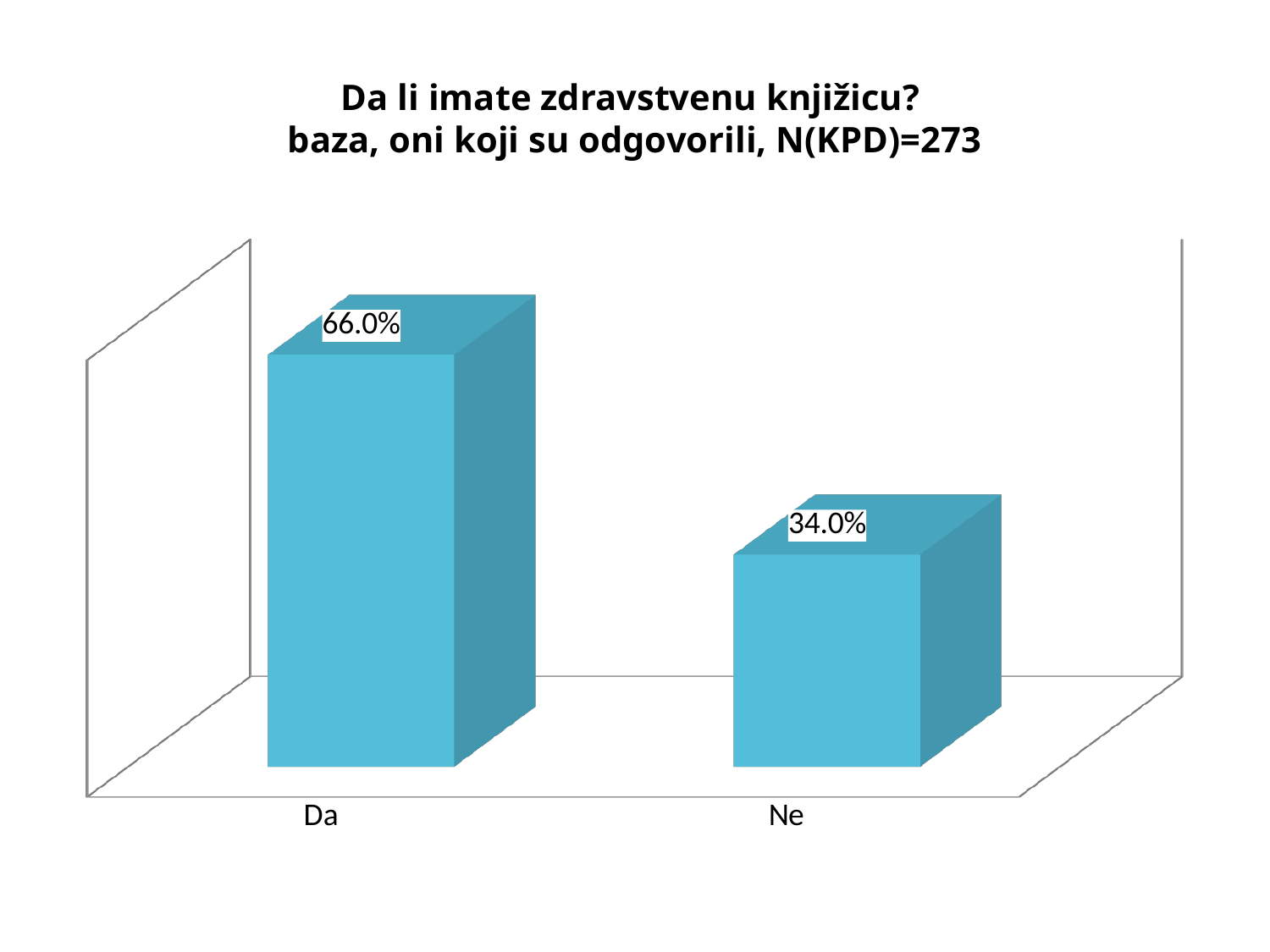
Which category has the highest value? Da Do the values rise or fall from "Da" to "Ne"? fall What is the value for "Ne"? 34.0% Which is larger, the value for "Da" or the value for "Ne"? Da What is the difference between the values for "Da" and "Ne"? 32.0% How many categories are shown on the x axis? 2 What is the total of the two values shown? 100.0% What is the sample size N(KPD) stated in the chart title? 273 What question does the chart title ask? Da li imate zdravstvenu knjižicu? Which category has the lowest value? Ne What kind of chart is shown on the slide? bar chart What is the value for "Da"? 66.0%